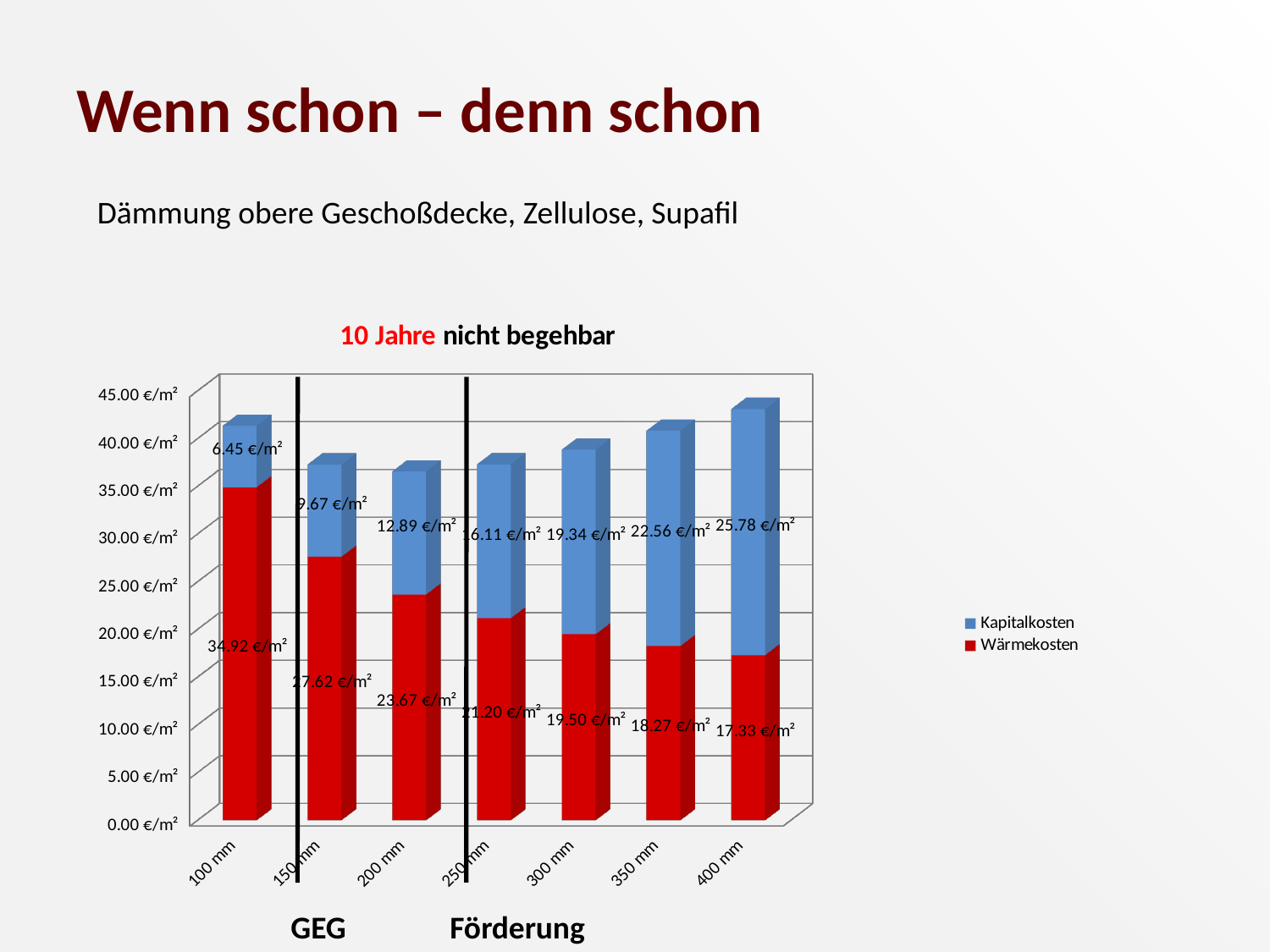
Which is larger for 350 mm: Kapitalkosten or Wärmekosten? Kapitalkosten How do the Kapitalkosten values change as the insulation thickness increases from 100 mm to 400 mm? They rise What is the Kapitalkosten value for 400 mm? 25.78 €/m² How many series does the legend list? 2 What is the Wärmekosten value for 300 mm? 19.50 €/m² What is the Kapitalkosten value for 200 mm? 12.89 €/m² What is the Wärmekosten value for 100 mm? 34.92 €/m² How many insulation thickness categories are shown on the x axis? 7 Which category has the lowest Kapitalkosten value? 100 mm Which category has the highest Wärmekosten value? 100 mm What type of chart is shown on the slide? stacked bar chart What is the total of the stacked bar for 400 mm? 43.11 €/m²